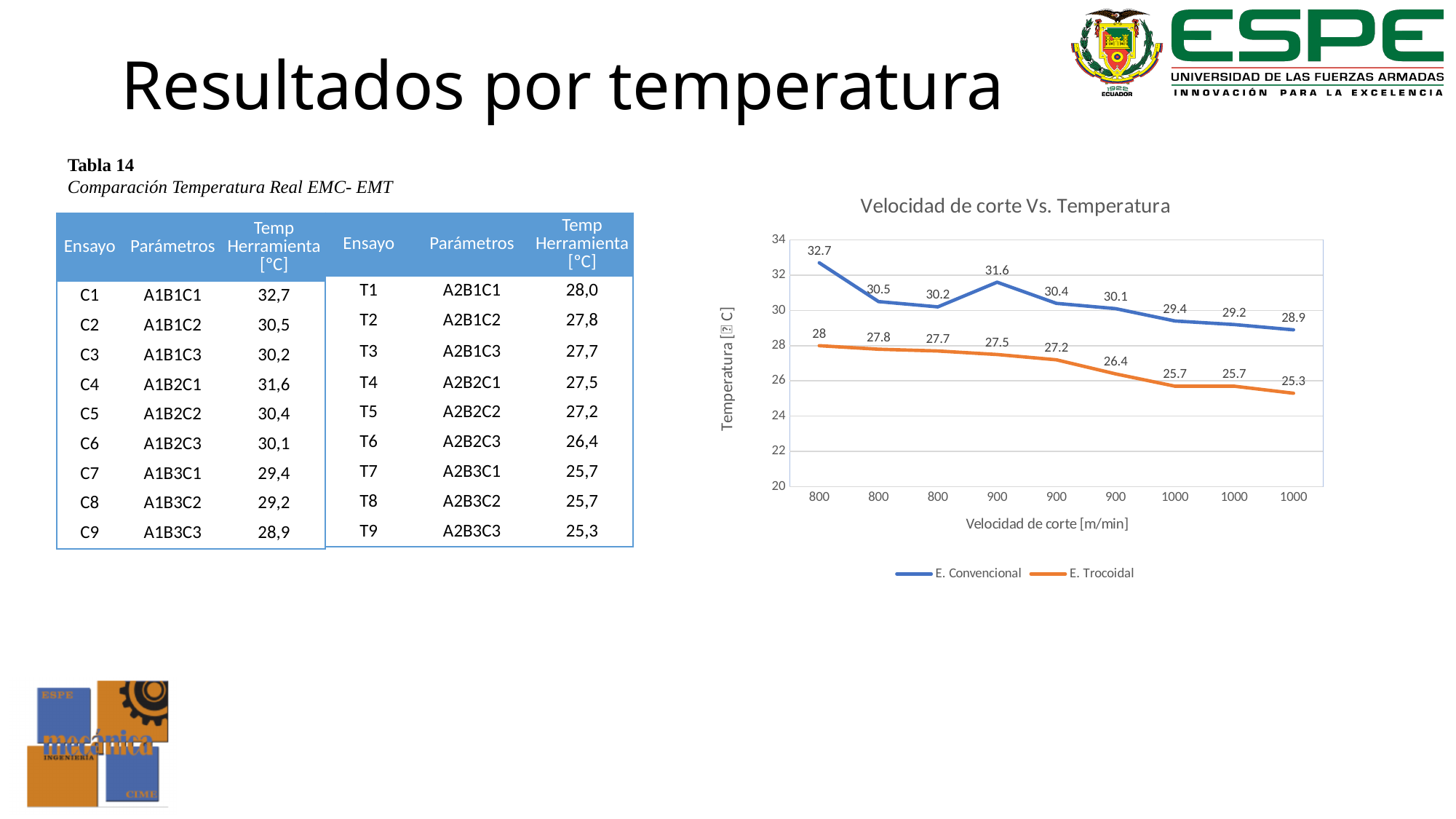
What is the highest value of the E. Trocoidal series in the chart? 28 What type of chart is 'Velocidad de corte Vs. Temperatura'? line chart What is the lowest value of the E. Convencional series in the chart? 28.9 What is the first (leftmost) value of the E. Convencional series in the chart? 32.7 How many data points does each series in the chart have? 9 Which colour is used for the E. Trocoidal series in the chart? orange Overall, do the values of the E. Trocoidal series rise or fall from left to right along the x axis? fall What is the last (rightmost) value of the E. Trocoidal series in the chart? 25.3 What is the difference between the first values of E. Convencional (32.7) and E. Trocoidal (28) in the chart? 4.7 At the last point on the x axis, which series has the higher temperature, E. Convencional or E. Trocoidal? E. Convencional How many series does the legend of the chart list? 2 What is the title of the y axis in the chart? Temperatura [°C]